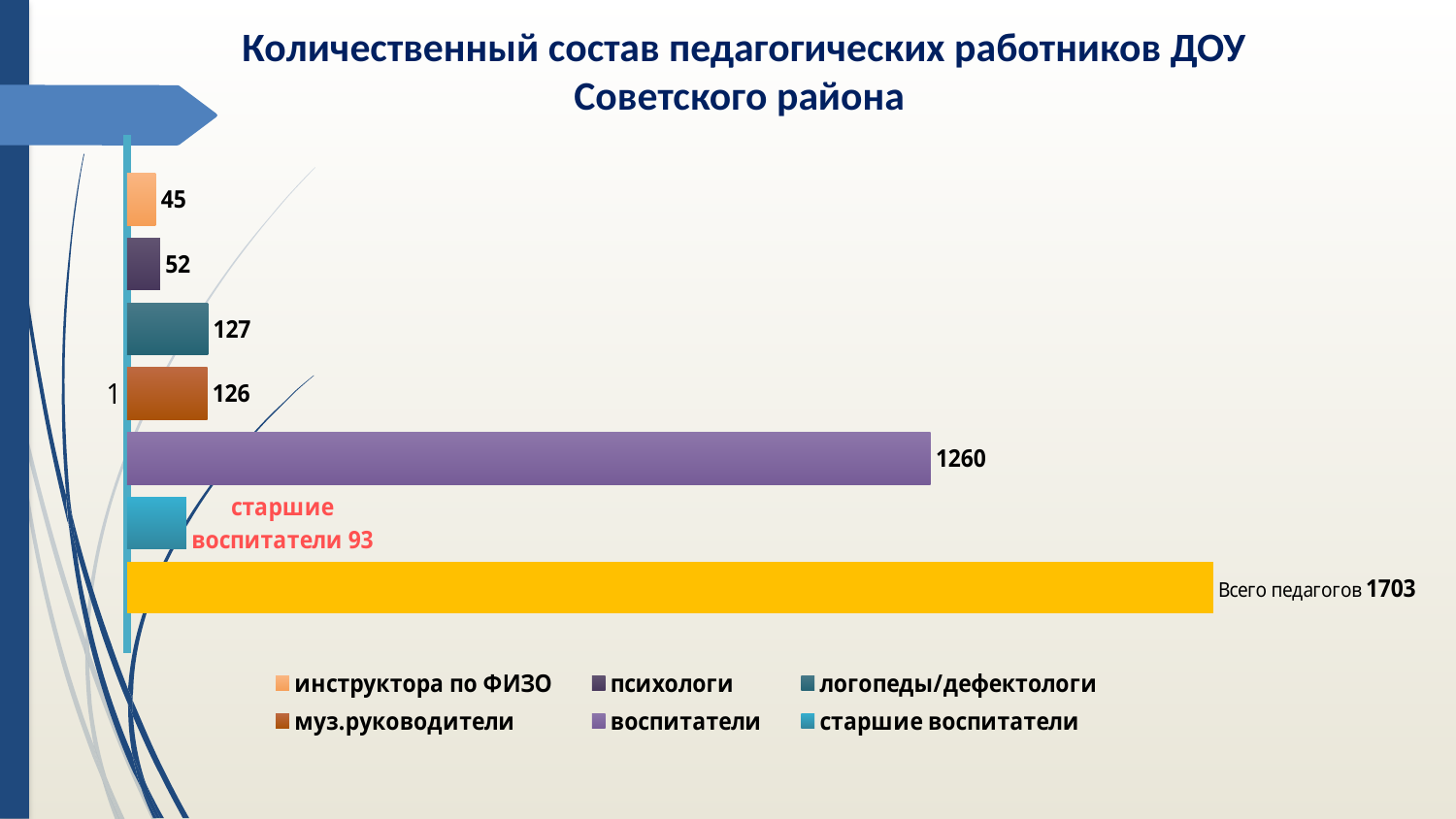
What is the value for психологи? 52 Which category in the legend has the lowest value? инструктора по ФИЗО Which category in the legend has the highest value? воспитатели What is the value for муз.руководители? 126 What is the difference between the values for воспитатели and старшие воспитатели? 1167 What type of chart is shown on the slide? bar chart What is the value for логопеды/дефектологи? 127 What is the value for инструктора по ФИЗО? 45 What is the value shown for Всего педагогов? 1703 What is the value for старшие воспитатели? 93 What is the value for воспитатели? 1260 How many series does the legend list? 6